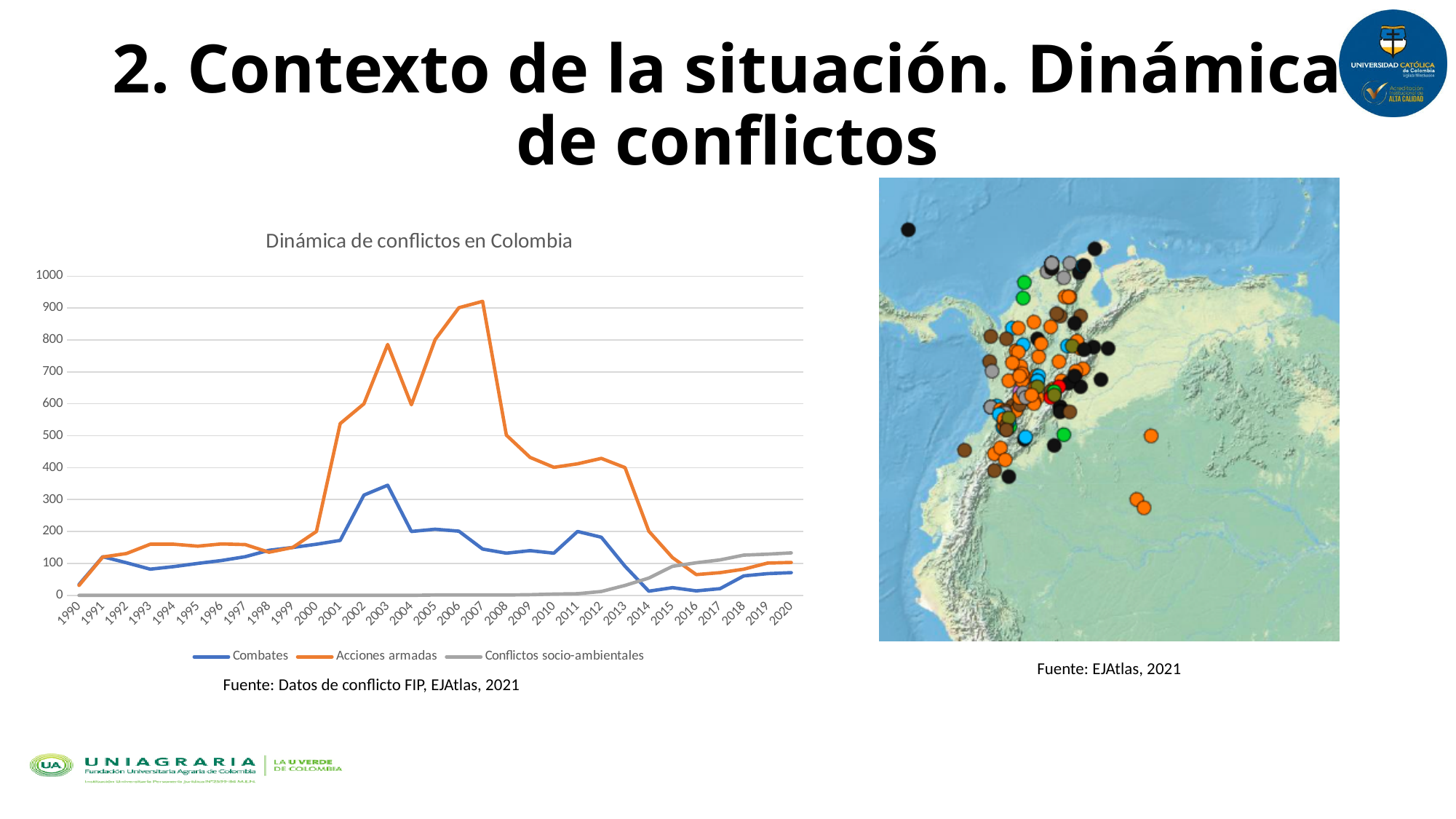
In the 'Dinámica de conflictos en Colombia' chart, which series has the higher value in 2020, Combates or Conflictos socio-ambientales? Conflictos socio-ambientales In the 'Dinámica de conflictos en Colombia' chart, does the Acciones armadas series rise or fall between 2007 and 2016? fall What kind of chart is 'Dinámica de conflictos en Colombia'? line chart How many series does the legend of the 'Dinámica de conflictos en Colombia' chart list? 3 In the 'Dinámica de conflictos en Colombia' chart, in which year does the Acciones armadas series reach its highest value? 2007 In the 'Dinámica de conflictos en Colombia' chart, is the value for Combates in 2003 greater or less than 300? greater In the 'Dinámica de conflictos en Colombia' chart, in which year does the Combates series reach its highest value? 2003 How many years are shown on the x axis of the 'Dinámica de conflictos en Colombia' chart? 31 In the 'Dinámica de conflictos en Colombia' chart, what colour is the Acciones armadas line? orange In the 'Dinámica de conflictos en Colombia' chart, is the value for Acciones armadas in 2007 greater or less than 800? greater In the 'Dinámica de conflictos en Colombia' chart, is the value for Combates in 2014 greater or less than 100? less In the 'Dinámica de conflictos en Colombia' chart, which series has the higher value in 2003, Combates or Acciones armadas? Acciones armadas